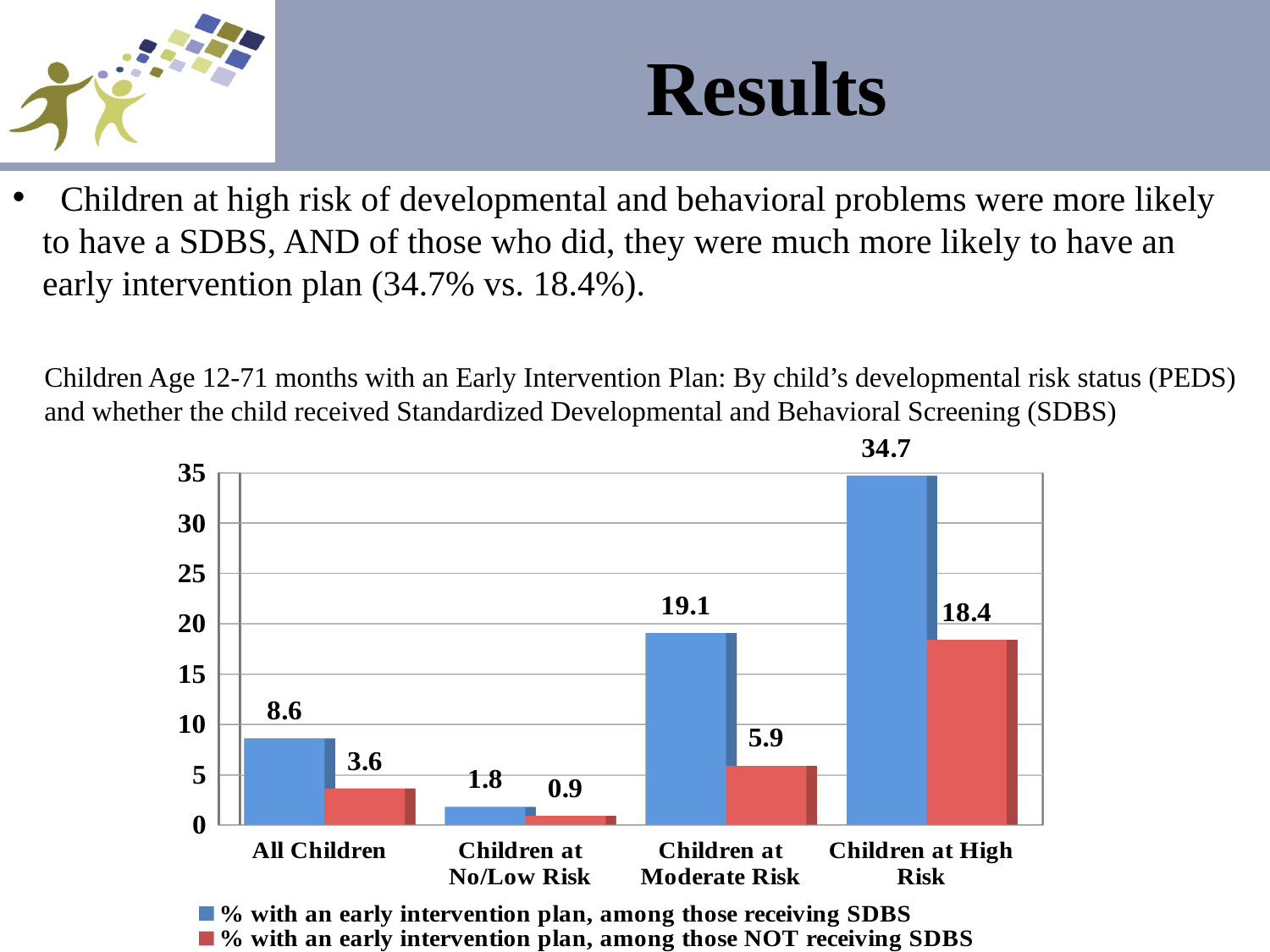
Do the values for the series among those receiving SDBS rise or fall from Children at No/Low Risk to Children at High Risk? Rise What kind of chart is shown on the slide? Bar chart Which category has the highest value among those receiving SDBS? Children at High Risk What is the value for Children at Moderate Risk in the series '% with an early intervention plan, among those NOT receiving SDBS'? 5.9 What is the difference between the two series' values for Children at High Risk? 16.3 Which category has the lowest value among those NOT receiving SDBS? Children at No/Low Risk What is the value for Children at High Risk in the series '% with an early intervention plan, among those receiving SDBS'? 34.7 Which is larger for Children at Moderate Risk: the value among those receiving SDBS or among those NOT receiving SDBS? Among those receiving SDBS How many series does the legend list? 2 How many categories are shown on the x axis? 4 What is the value for All Children among those receiving SDBS? 8.6 What is the difference between the two series' values for All Children? 5.0